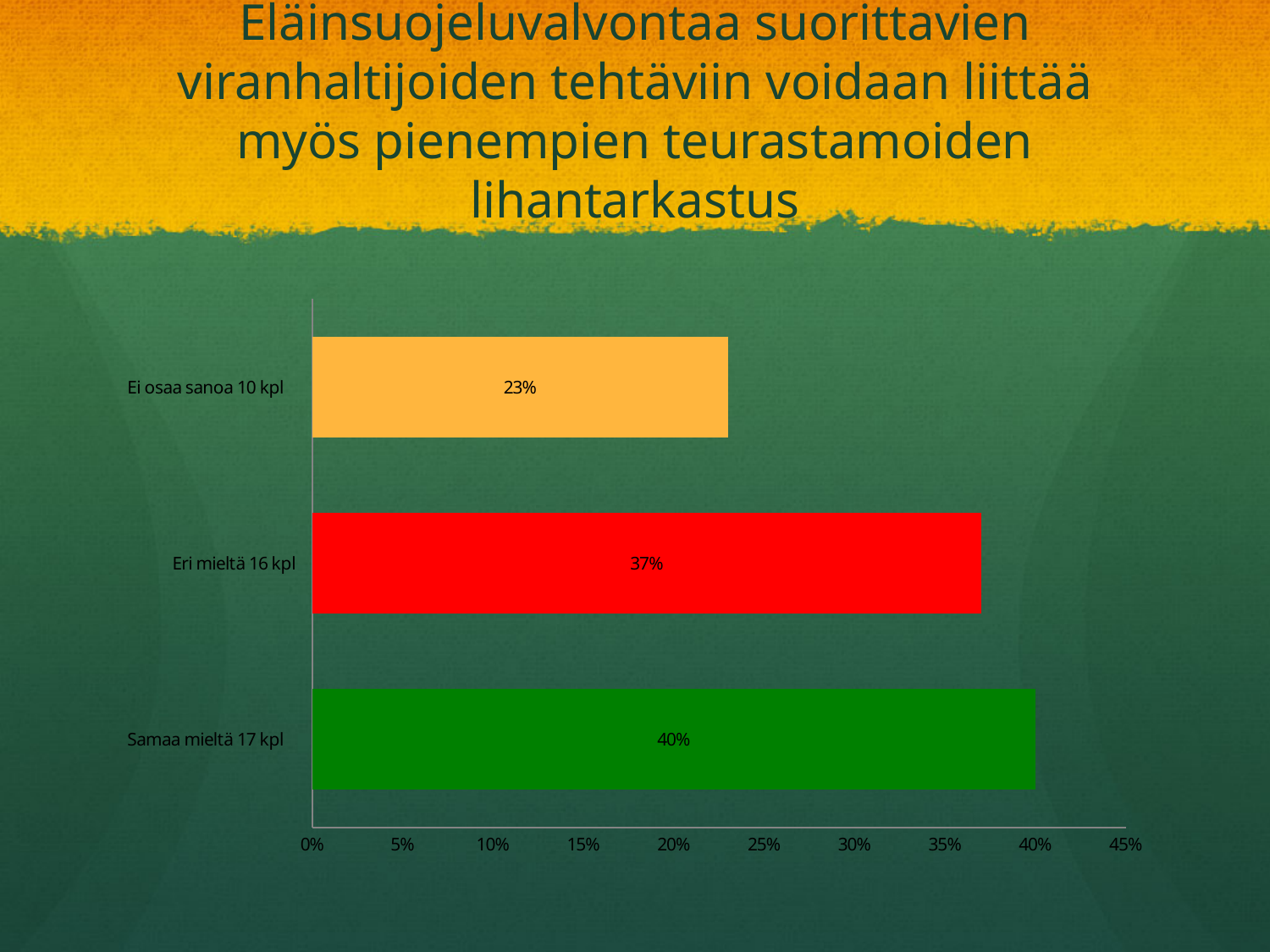
Is the value for "Ei osaa sanoa 10 kpl" greater or less than 25%? less Which category has the highest value? Samaa mieltä 17 kpl What is the value for "Eri mieltä 16 kpl"? 37% What kind of chart is shown on the slide? bar chart What is the difference between the values for "Eri mieltä 16 kpl" and "Ei osaa sanoa 10 kpl"? 14% What is the value for "Ei osaa sanoa 10 kpl"? 23% What colour is the bar for "Eri mieltä 16 kpl"? red What is the difference between the values for "Samaa mieltä 17 kpl" and "Eri mieltä 16 kpl"? 3% Which category has the lowest value? Ei osaa sanoa 10 kpl Which is larger, the value for "Eri mieltä 16 kpl" or the value for "Ei osaa sanoa 10 kpl"? Eri mieltä 16 kpl What is the value for "Samaa mieltä 17 kpl"? 40% How many categories are shown in the chart? 3